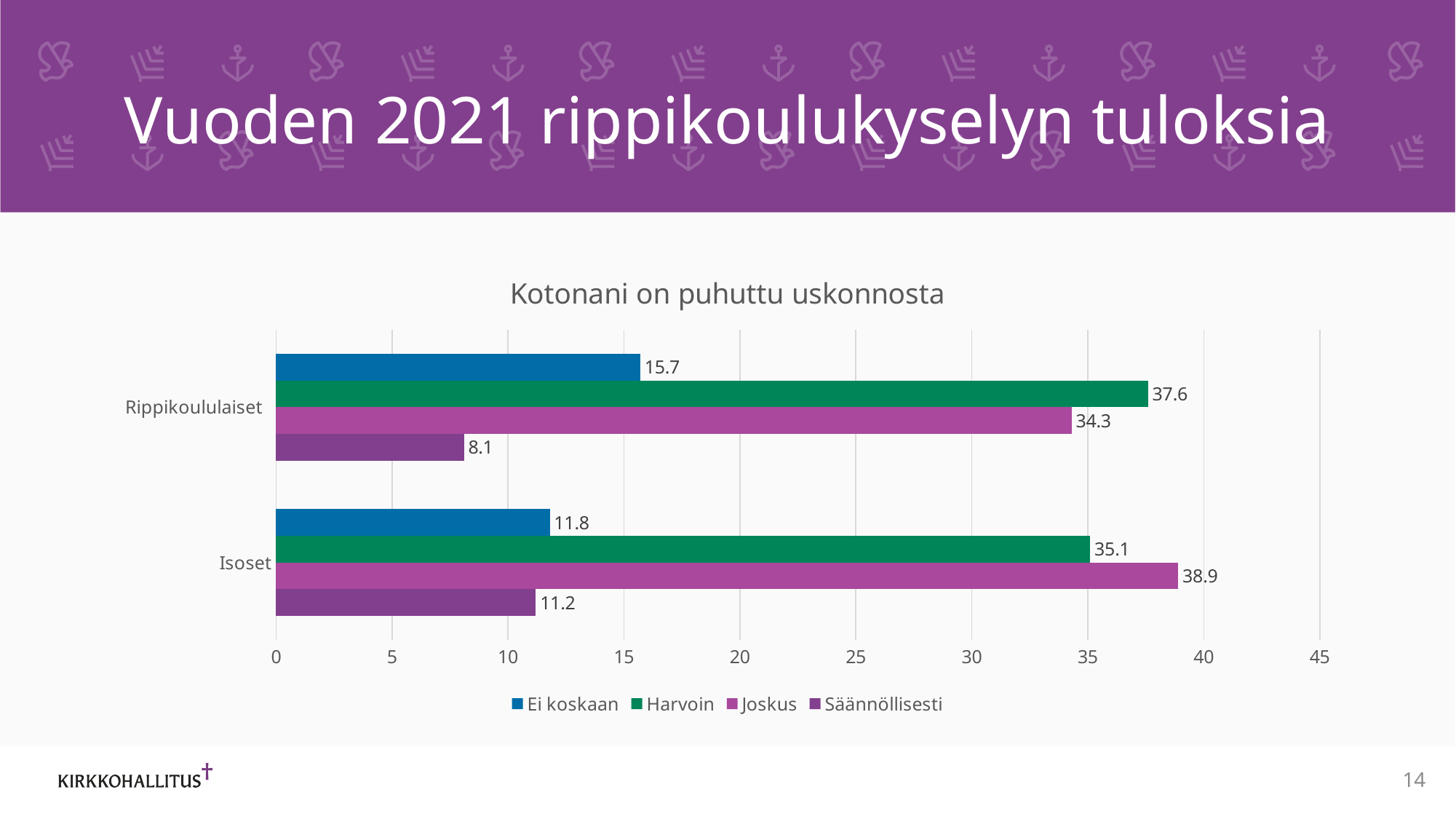
What kind of chart is shown on the slide? Bar chart How many series does the legend list? 4 Which series has the lowest value in the Rippikoululaiset category? Säännöllisesti Which series has the highest value in the Isoset category? Joskus How many categories are shown on the y axis? 2 What is the difference between the Harvoin and Joskus values for Rippikoululaiset? 3.3 What is the value for Harvoin in the Rippikoululaiset category? 37.6 What is the title of the chart? Kotonani on puhuttu uskonnosta Which is larger: Ei koskaan for Rippikoululaiset or Ei koskaan for Isoset? Rippikoululaiset What is the value for Säännöllisesti in the Isoset category? 11.2 Is the value for Joskus in the Isoset category greater or less than 35? greater What is the value for Joskus in the Isoset category? 38.9